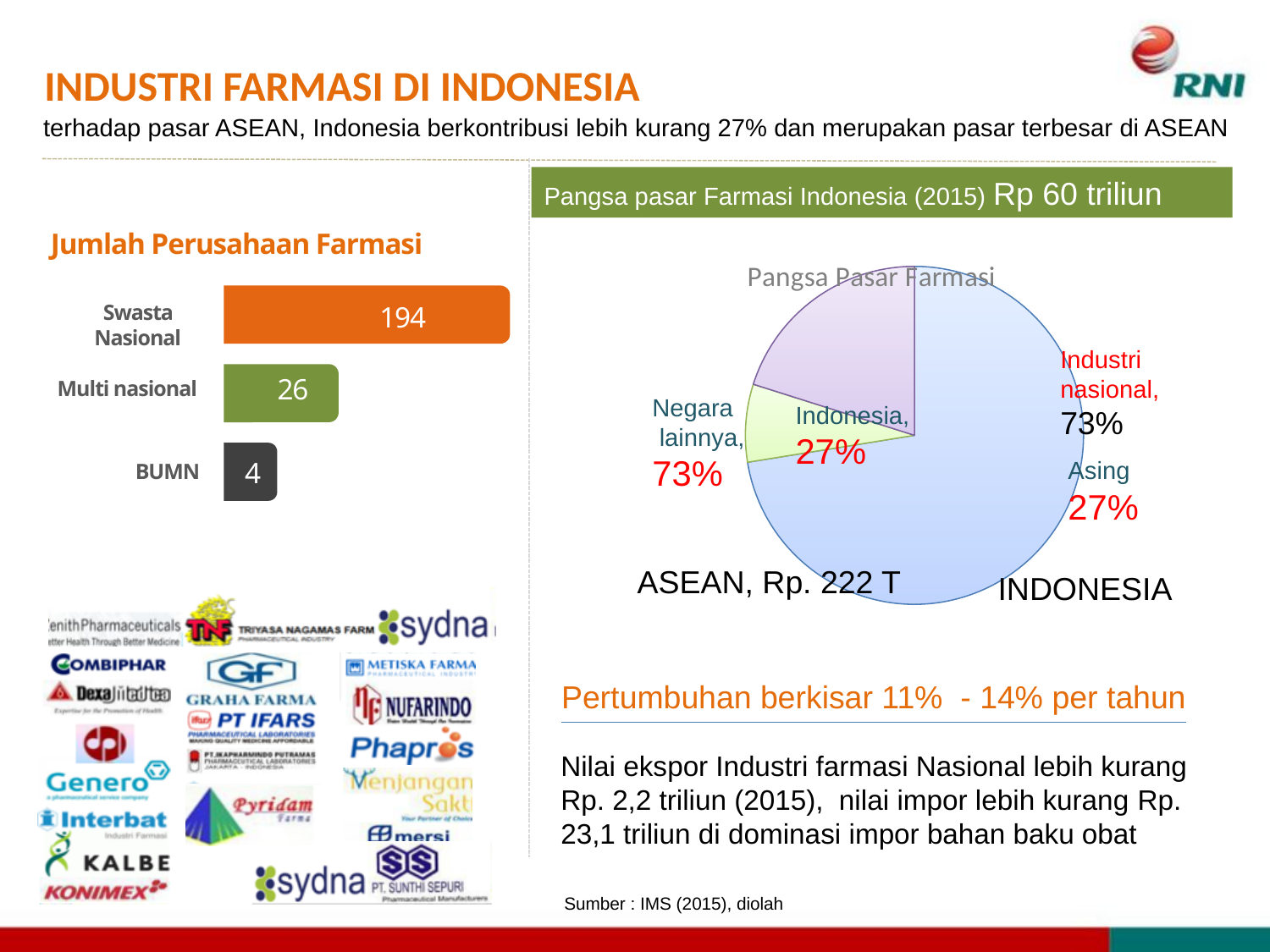
What kind of chart is 'Jumlah Perusahaan Farmasi'? Bar chart How many categories are shown in the 'Jumlah Perusahaan Farmasi' chart? 3 In the 'Jumlah Perusahaan Farmasi' chart, what is the difference between Swasta Nasional and Multi nasional? 168 In the 'Jumlah Perusahaan Farmasi' chart, what is the value for Swasta Nasional? 194 What kind of chart is 'Pangsa Pasar Farmasi'? Pie chart In the 'Jumlah Perusahaan Farmasi' chart, what is the value for Multi nasional? 26 In the 'Jumlah Perusahaan Farmasi' chart, which category has the highest value? Swasta Nasional In the 'Jumlah Perusahaan Farmasi' chart, what is the value for BUMN? 4 In the 'Jumlah Perusahaan Farmasi' chart, which is larger: Multi nasional or BUMN? Multi nasional In the 'Pangsa Pasar Farmasi' pie chart, what share is labelled for Indonesia? 27% In the 'Jumlah Perusahaan Farmasi' chart, which category has the lowest value? BUMN In the 'Pangsa Pasar Farmasi' pie chart, what share is labelled for Negara lainnya? 73%